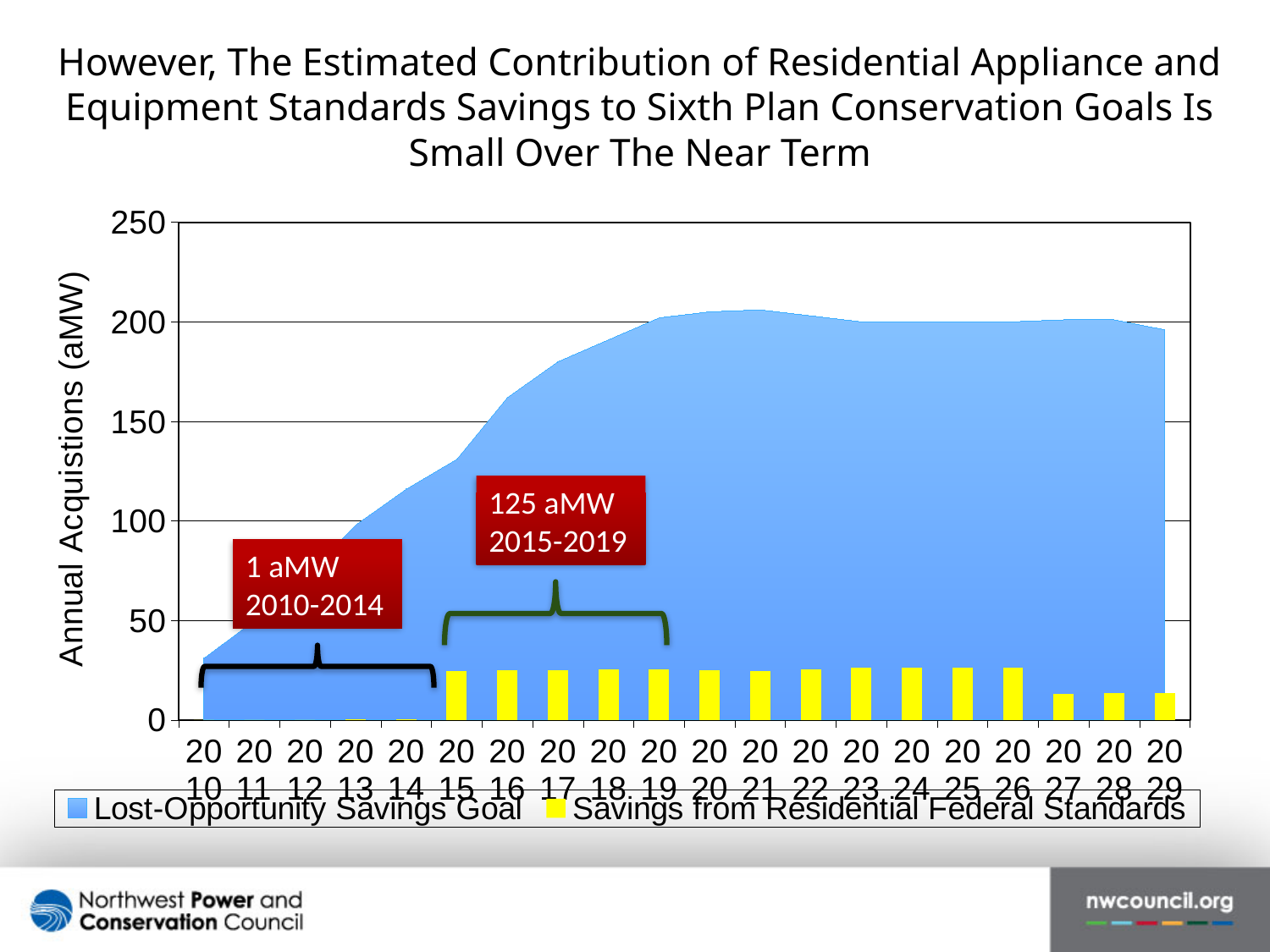
Is the Savings from Residential Federal Standards value for 2018 greater or less than 50? less In which year is the Lost-Opportunity Savings Goal lowest? 2010 Is the Lost-Opportunity Savings Goal for 2020 greater or less than 200? greater How many years are shown along the x axis? 20 How many series does the legend list? 2 Which is larger, the Savings from Residential Federal Standards in 2020 or in 2028? 2020 What kind of chart is this? A combined area and bar chart Is the Lost-Opportunity Savings Goal for 2010 greater or less than 50? less What are the two series named in the legend? Lost-Opportunity Savings Goal; Savings from Residential Federal Standards Which is larger, the Lost-Opportunity Savings Goal in 2012 or in 2022? 2022 What is the label on the vertical axis? Annual Acquistions (aMW) Does the Lost-Opportunity Savings Goal rise or fall from 2010 to 2020? Rise